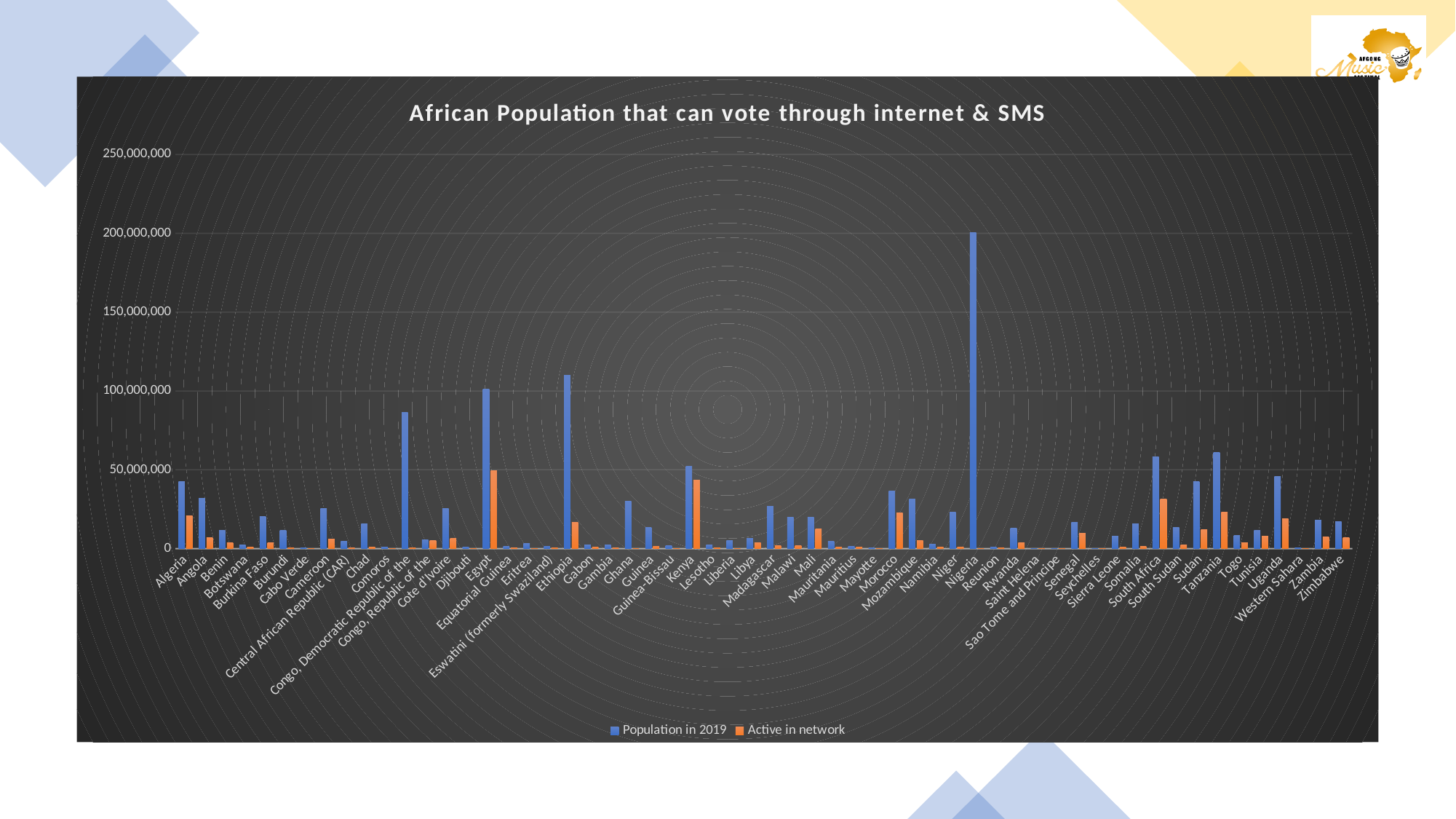
Which is larger, the Population in 2019 for Kenya or for Ghana? Kenya How many series does the legend list? 2 Is the Population in 2019 value for South Africa greater or less than 50,000,000? greater Which country has the highest value for Population in 2019? Nigeria Which colour represents the 'Active in network' series? Orange Is the Active in network value for Kenya greater or less than 50,000,000? less Which country has the highest value for Active in network? Egypt Is the Population in 2019 value for Nigeria greater or less than 150,000,000? greater What is the title of the chart? African Population that can vote through internet & SMS What kind of chart is shown on the slide? Bar chart Which is larger, the Population in 2019 for Nigeria or for Ethiopia? Nigeria